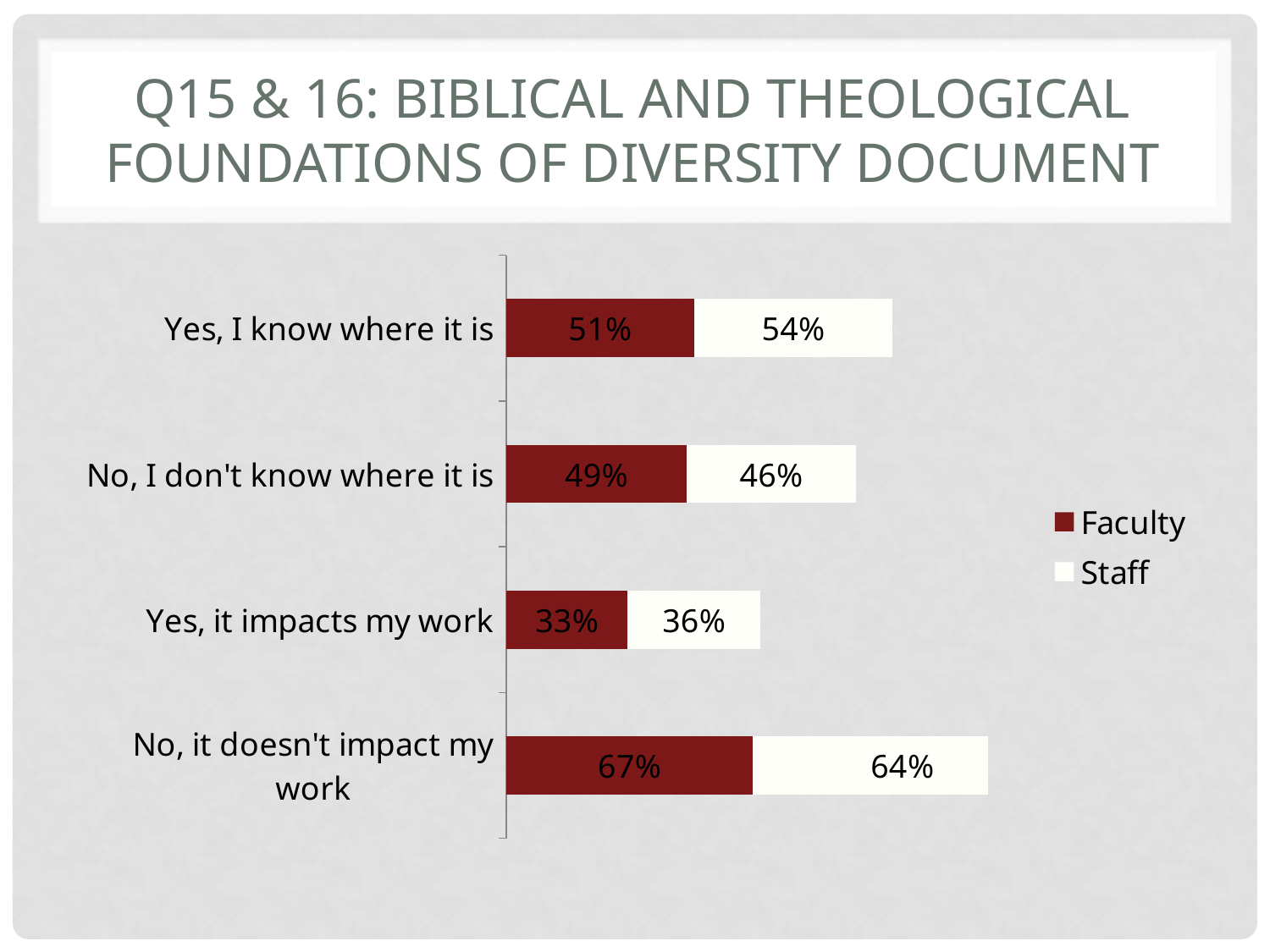
What kind of chart is shown on the slide? Stacked bar chart What is the Staff value for "Yes, it impacts my work"? 36% What is the Faculty value for "Yes, I know where it is"? 51% How many series does the legend list? 2 What is the difference between the Faculty and Staff values for "No, it doesn't impact my work"? 3% Which category has the highest Faculty value? No, it doesn't impact my work Which category has the lowest Staff value? Yes, it impacts my work What is the Staff value for "No, I don't know where it is"? 46% What colour represents the Faculty series? Dark red What is the Faculty value for "No, it doesn't impact my work"? 67% For "Yes, I know where it is", which is larger, the Faculty value or the Staff value? Staff How many categories are shown on the chart? 4